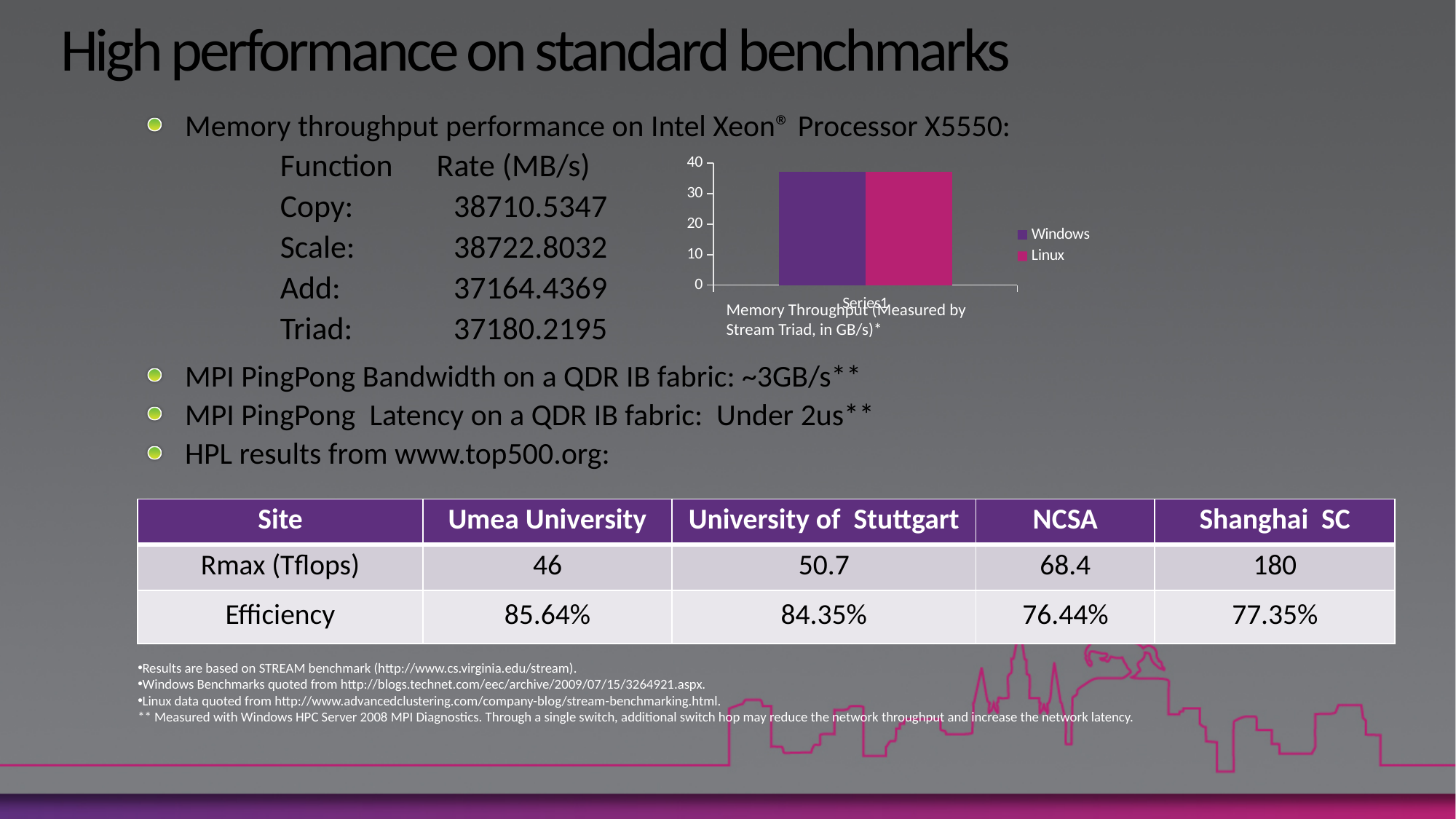
Is the value of the Linux bar greater or less than 30? greater Is the value of the Windows bar greater or less than 30? greater How many categories are plotted on the chart's x axis? 1 Is the value of the Linux bar greater or less than 20? greater What kind of chart is shown on the slide? bar chart What is the highest tick value shown on the chart's vertical axis? 40 Which series are listed in the chart's legend? Windows and Linux How many series does the chart's legend list? 2 What is the category label shown on the chart's x axis? Series1